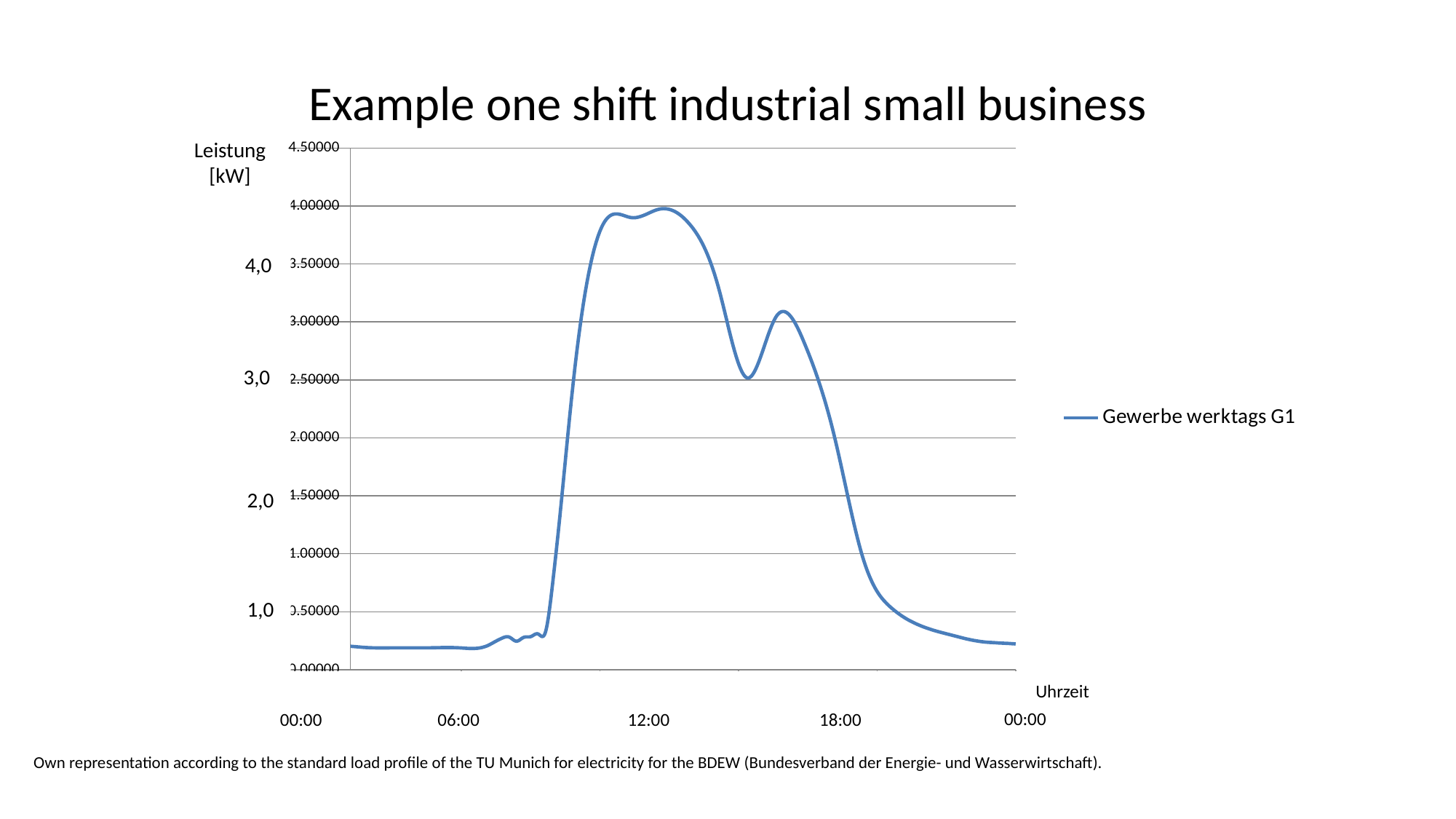
How many series does the legend list? 1 Is the value for Gewerbe werktags G1 at 06:00 greater or less than 0.50000? less Is the value for Gewerbe werktags G1 at 12:00 greater or less than 3.50000? greater Does the value for Gewerbe werktags G1 rise or fall between 12:00 and 18:00? fall Which of the labelled times, 06:00 or 12:00, has the higher value for Gewerbe werktags G1? 12:00 What kind of chart is shown on the slide? line chart What is the title of the chart? Example one shift industrial small business What is the name of the series shown in the legend? Gewerbe werktags G1 Is the value for Gewerbe werktags G1 at 18:00 greater or less than 2.00000? less How many time labels are shown on the x axis? 5 Does the value for Gewerbe werktags G1 rise or fall between 06:00 and 12:00? rise